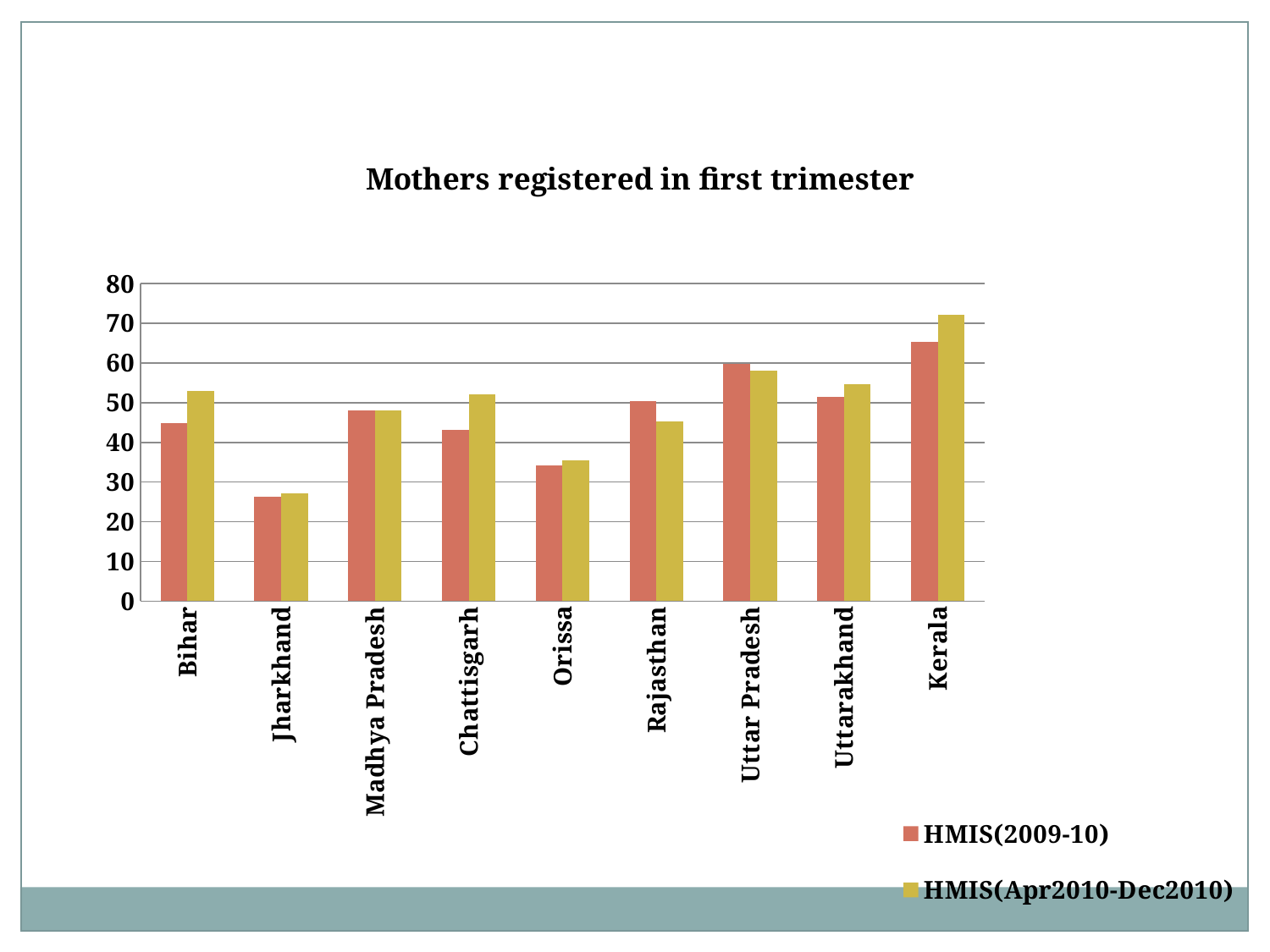
For Bihar, which series has the larger value, HMIS(2009-10) or HMIS(Apr2010-Dec2010)? HMIS(Apr2010-Dec2010) Is the HMIS(Apr2010-Dec2010) value for Orissa greater or less than 40? less How many series does the legend list? 2 For Rajasthan, which series has the larger value, HMIS(2009-10) or HMIS(Apr2010-Dec2010)? HMIS(2009-10) Which state has the lowest value for HMIS(2009-10)? Jharkhand How many states are shown on the x axis? 9 What is the title of the chart? Mothers registered in first trimester Is the HMIS(Apr2010-Dec2010) value for Kerala greater or less than 60? greater Which state has the highest value for HMIS(Apr2010-Dec2010)? Kerala What kind of chart is shown on the slide? bar chart Is the HMIS(2009-10) value for Bihar greater or less than 50? less Which state has the highest value for HMIS(2009-10)? Kerala